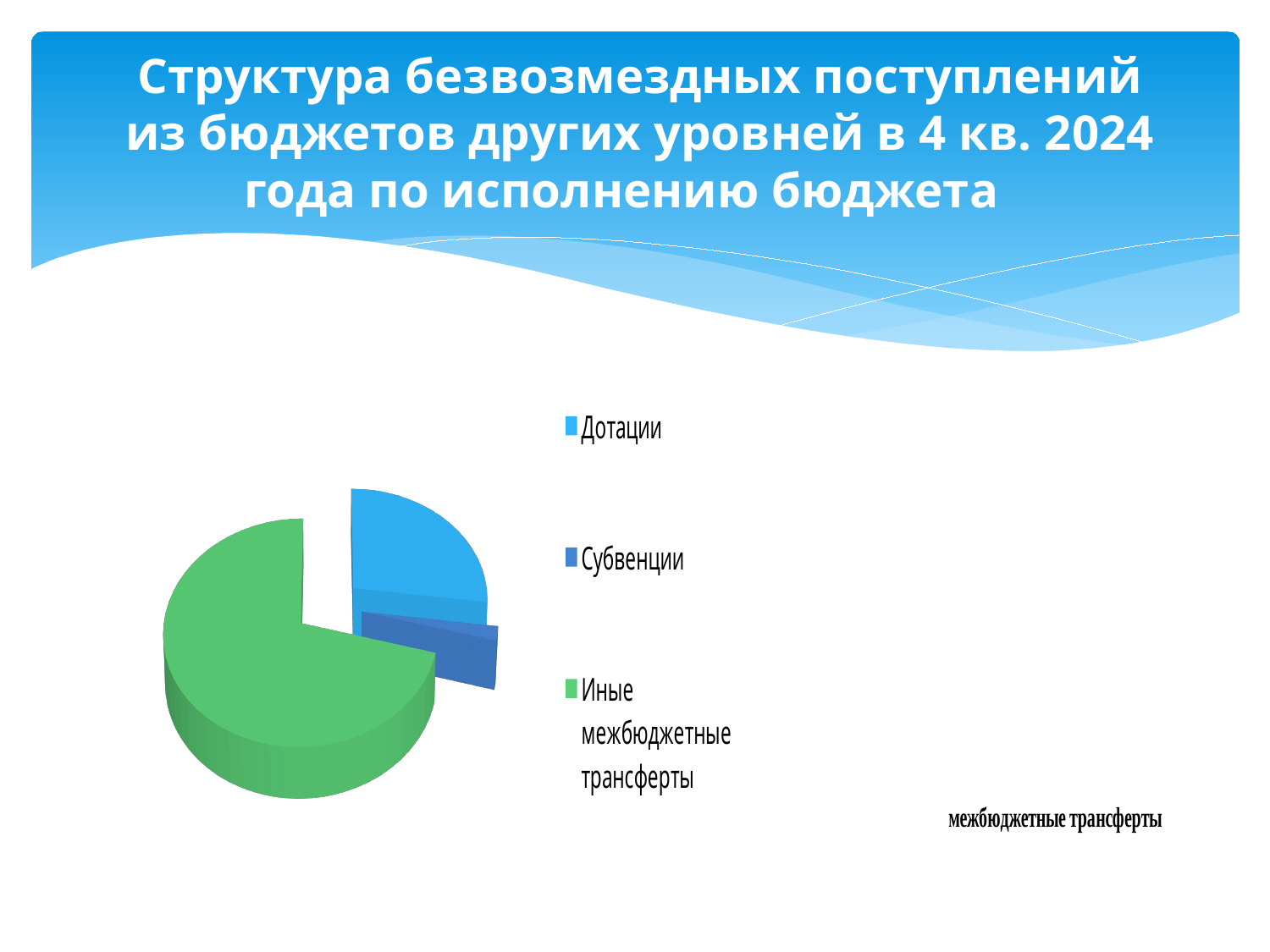
How many entries does the legend of the pie chart list? 3 Which category has the largest slice in the pie chart? Иные межбюджетные трансферты What kind of chart is shown on the slide? pie chart Which slice is larger in the pie chart, Дотации or Субвенции? Дотации Which category has the smallest slice in the pie chart? Субвенции How many slices does the pie chart have? 3 Which slice is larger in the pie chart, Субвенции or Иные межбюджетные трансферты? Иные межбюджетные трансферты Which slice is larger in the pie chart, Дотации or Иные межбюджетные трансферты? Иные межбюджетные трансферты Which category is listed first in the legend of the pie chart? Дотации What colour is the slice for Иные межбюджетные трансферты in the pie chart? green